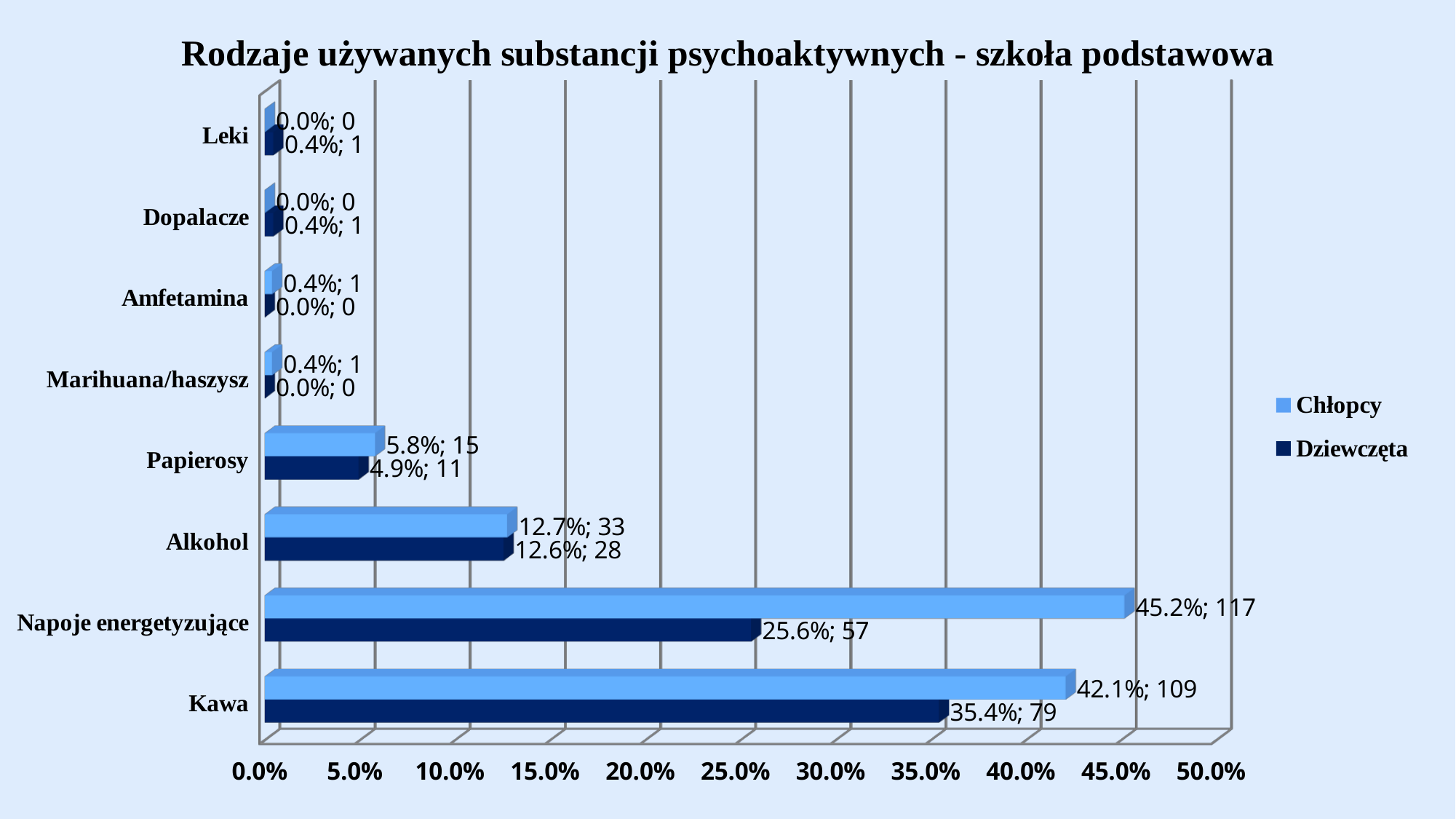
Which category has the highest value for Dziewczęta? Kawa How many series does the legend list? 2 Which is larger for Kawa, the Chłopcy value or the Dziewczęta value? Chłopcy Which category has the highest value for Chłopcy? Napoje energetyzujące How many Chłopcy are reported for Papierosy? 15 What is the value for Dziewczęta for Kawa? 35.4%; 79 What kind of chart is shown on the slide? Bar chart What percentage is shown for Dziewczęta for Alkohol? 12.6% What is the value for Chłopcy for Napoje energetyzujące? 45.2%; 117 What is the title of the chart? Rodzaje używanych substancji psychoaktywnych - szkoła podstawowa What is the difference in percentage points between Chłopcy and Dziewczęta for Napoje energetyzujące? 19.6 How many categories are shown on the chart? 8